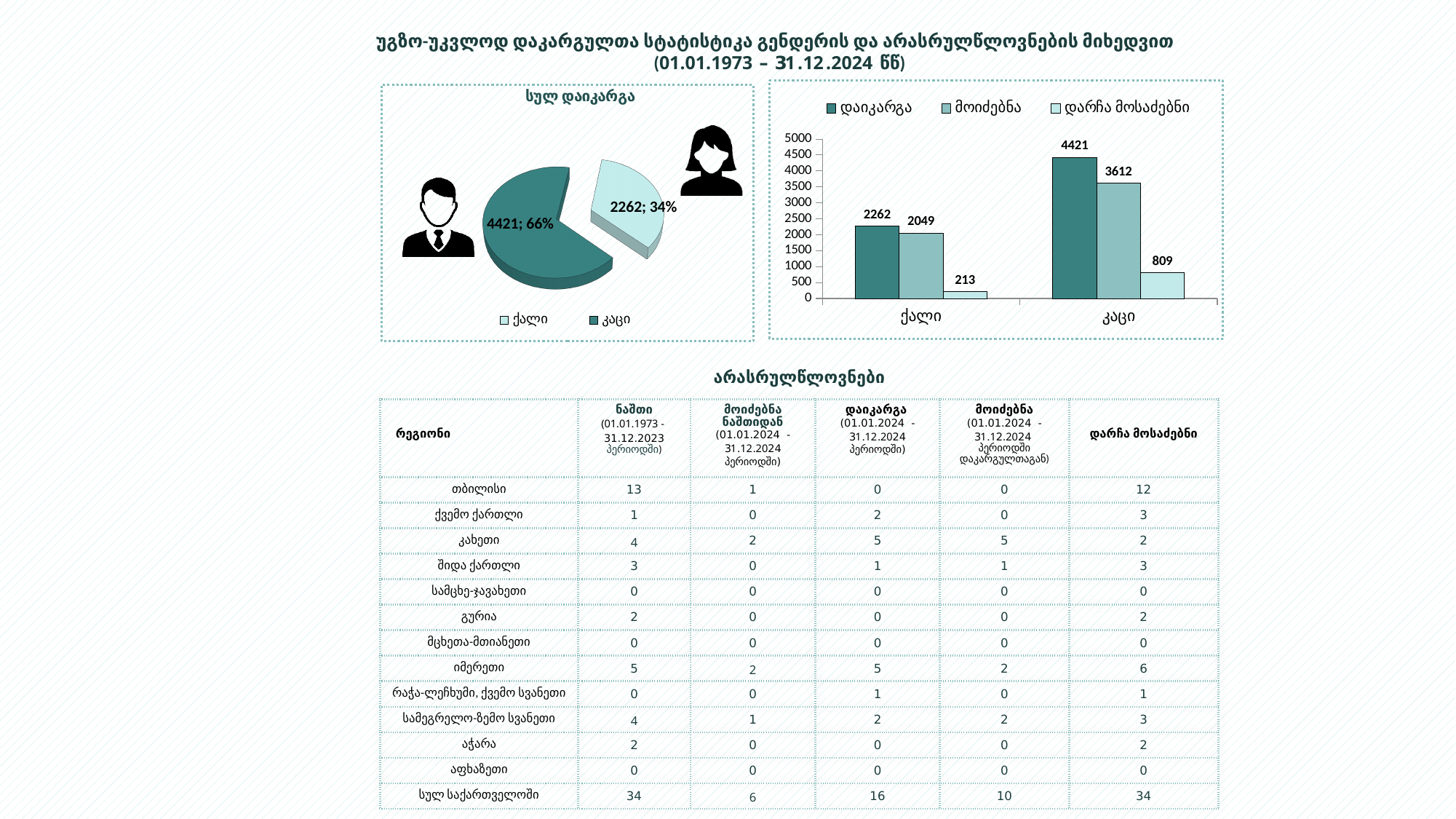
What kind of chart is the chart on the right of the slide? bar chart In the pie chart titled "სულ დაიკარგა", what value and share are shown for the "კაცი" slice? 4421; 66% In the pie chart titled "სულ დაიკარგა", which slice is larger, "ქალი" or "კაცი"? კაცი In the pie chart titled "სულ დაიკარგა", what share of the pie does the "ქალი" slice represent? 34% In the bar chart on the right, which category has the highest "დარჩა მოსაძებნი" value? კაცი In the bar chart on the right, what is the difference between "დაიკარგა" for "კაცი" and "დაიკარგა" for "ქალი"? 2159 In the bar chart on the right, what is the value of "მოიძებნა" for "კაცი"? 3612 In the bar chart on the right, how many series does the legend list? 3 In the bar chart on the right, how many categories are shown on the x axis? 2 In the bar chart on the right, what is the value of "დარჩა მოსაძებნი" for "ქალი"? 213 What kind of chart is the chart on the left titled "სულ დაიკარგა"? pie chart In the bar chart on the right, what is the difference between "დაიკარგა" and "მოიძებნა" for "კაცი"? 809